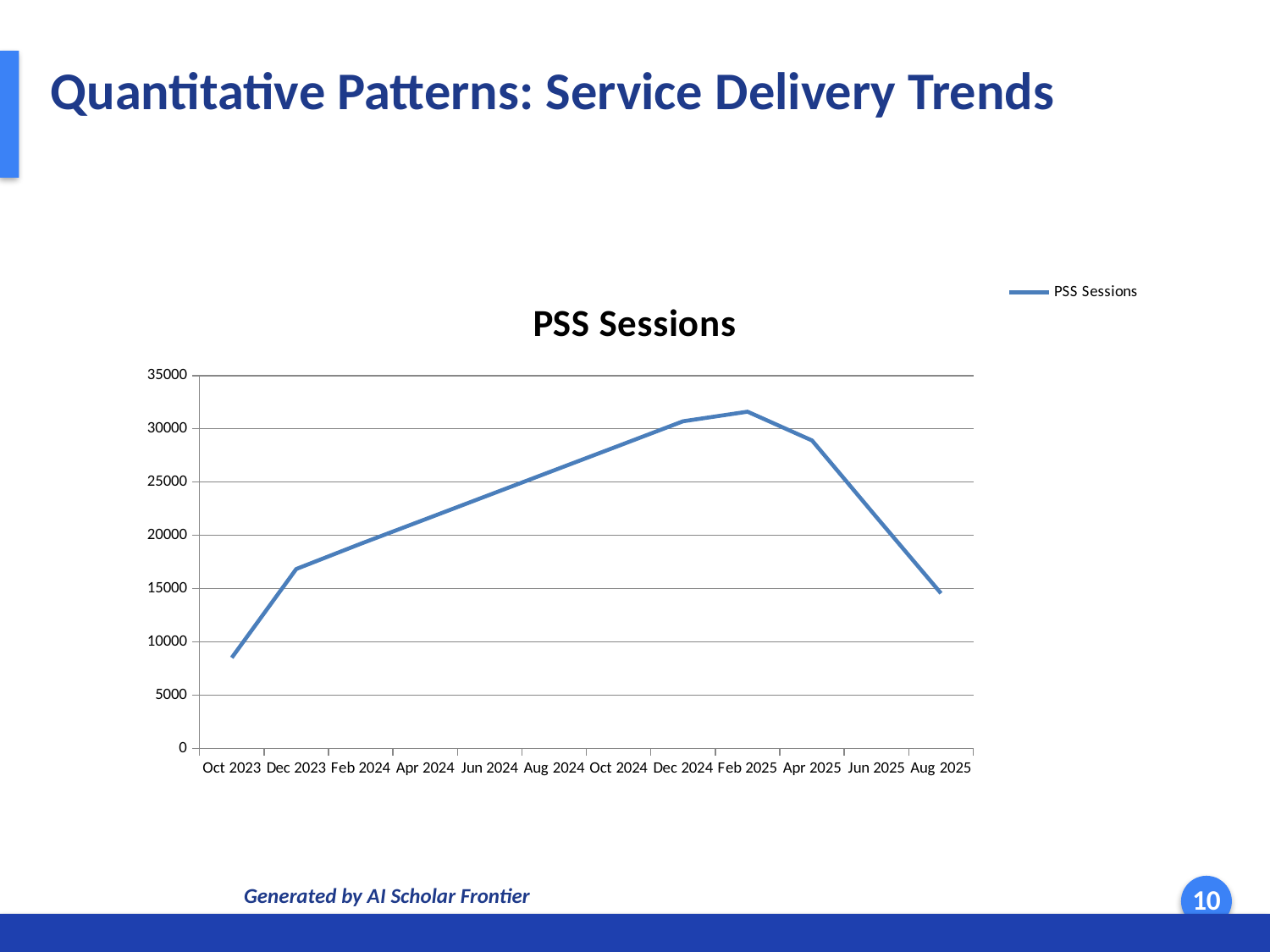
What kind of chart is shown on the slide? Line chart Which has the larger value, Feb 2025 or Apr 2025? Feb 2025 How many series does the legend list? 1 Is the value for Aug 2025 greater or less than 20000? less How many month labels are shown along the x axis? 12 Is the value for Apr 2025 greater or less than 30000? less How do PSS Sessions change from Feb 2025 to Aug 2025? They fall Is the value for Oct 2023 greater or less than 10000? less In which month are PSS Sessions lowest? Oct 2023 What is the title of the chart? PSS Sessions In which month do PSS Sessions reach their highest value? Feb 2025